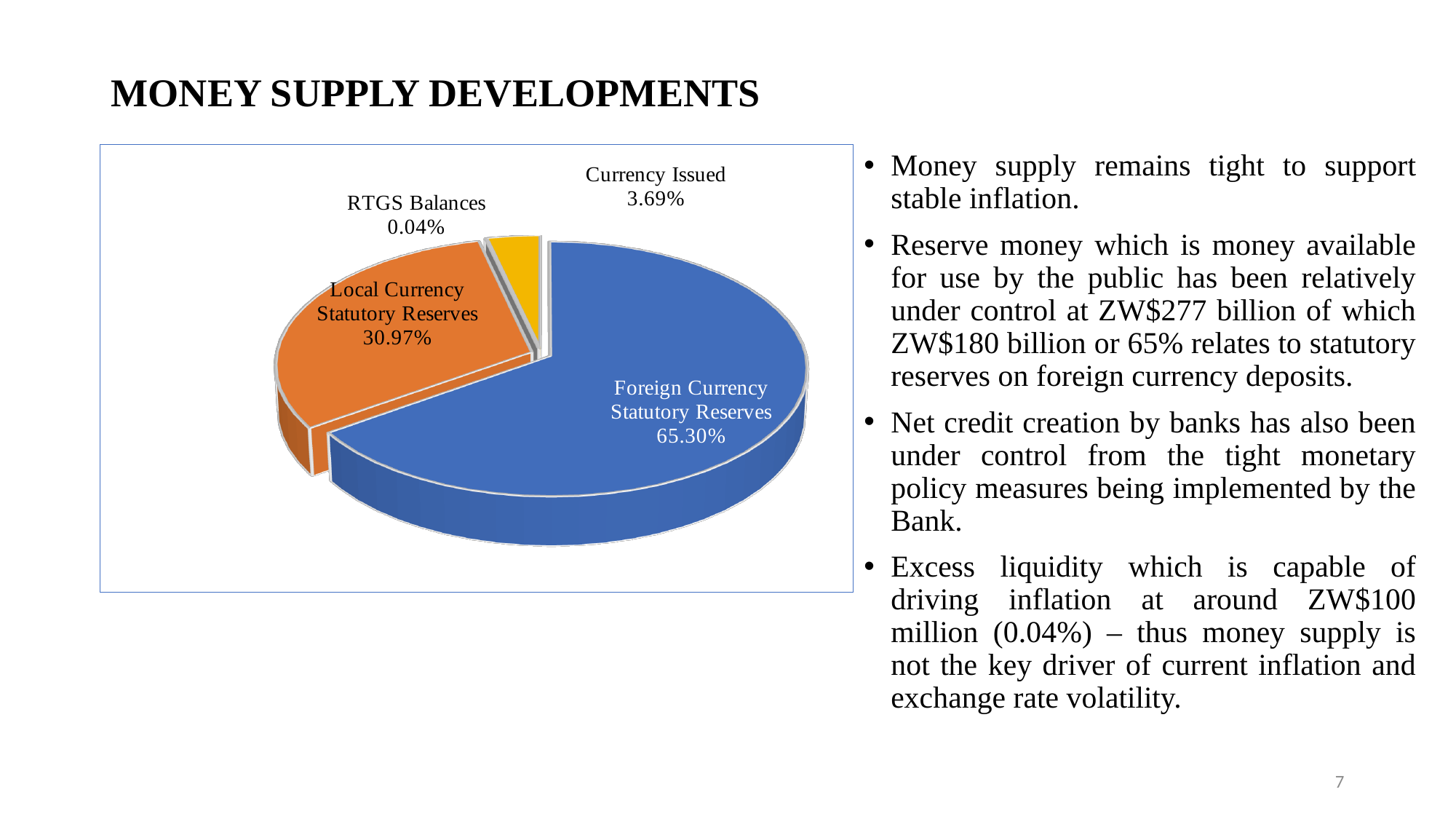
What share of the pie does RTGS Balances hold? 0.04% What is the combined share of Currency Issued and RTGS Balances? 3.73% What is the difference in percentage points between Foreign Currency Statutory Reserves and Local Currency Statutory Reserves? 34.33 What kind of chart is shown on the slide? Pie chart What share of the pie does Local Currency Statutory Reserves hold? 30.97% Which slice of the pie is the smallest? RTGS Balances What share of the pie does Currency Issued hold? 3.69% Which slice of the pie is the largest? Foreign Currency Statutory Reserves How many slices does the pie chart have? 4 What share of the pie does Foreign Currency Statutory Reserves hold? 65.30% What colour is the Local Currency Statutory Reserves slice? Orange Which is larger, Currency Issued or RTGS Balances? Currency Issued